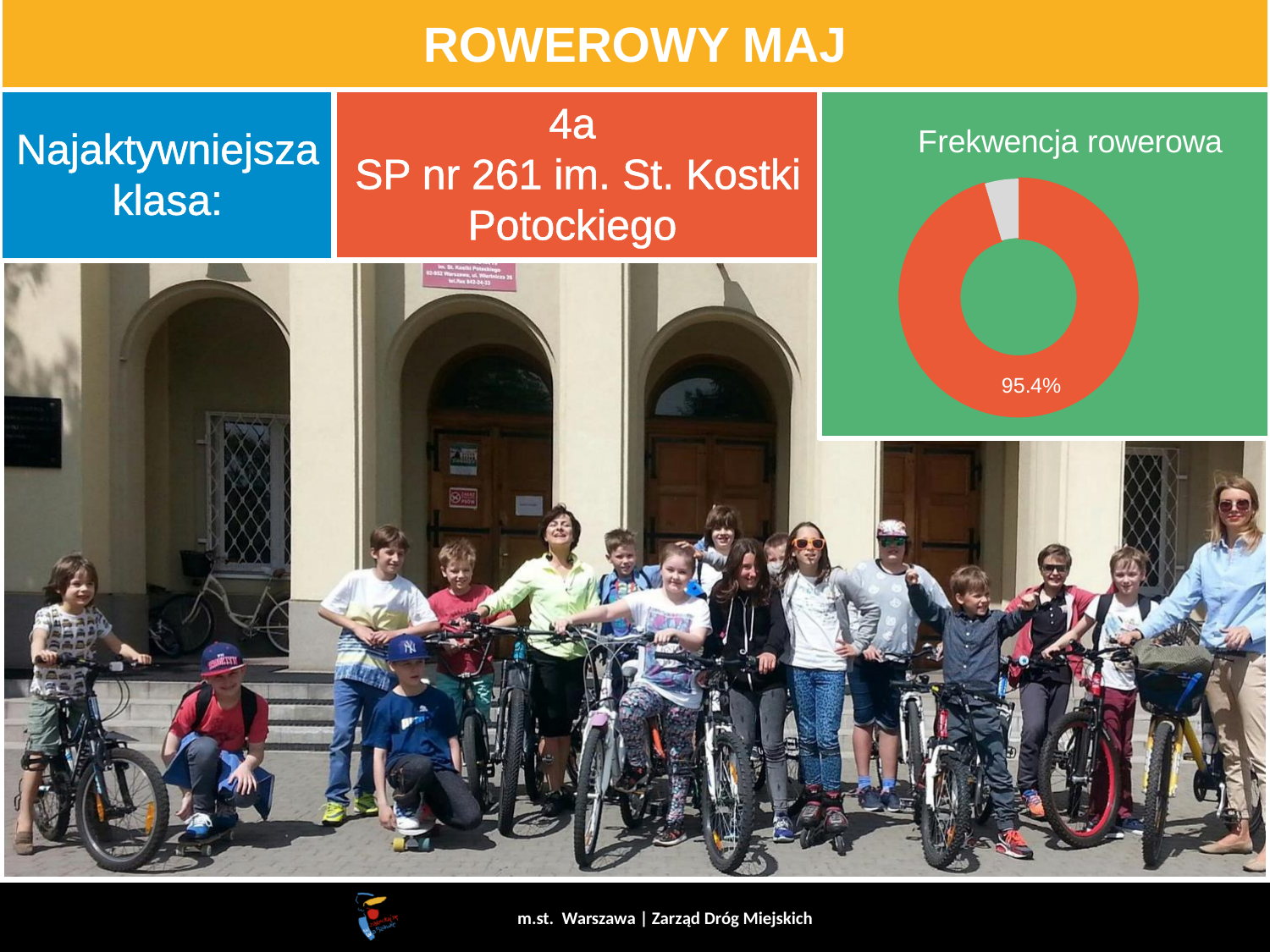
What value is printed on the large orange slice of the "Frekwencja rowerowa" chart? 95.4% What is the title of the chart on the slide? Frekwencja rowerowa What kind of chart is shown under the title "Frekwencja rowerowa"? Donut (pie) chart What share of the "Frekwencja rowerowa" donut does the orange slice represent? 95.4% How many slices does the "Frekwencja rowerowa" donut chart have? 2 What colour is the largest slice of the "Frekwencja rowerowa" chart? Orange In the "Frekwencja rowerowa" chart, which slice is larger, the orange one or the grey one? The orange one